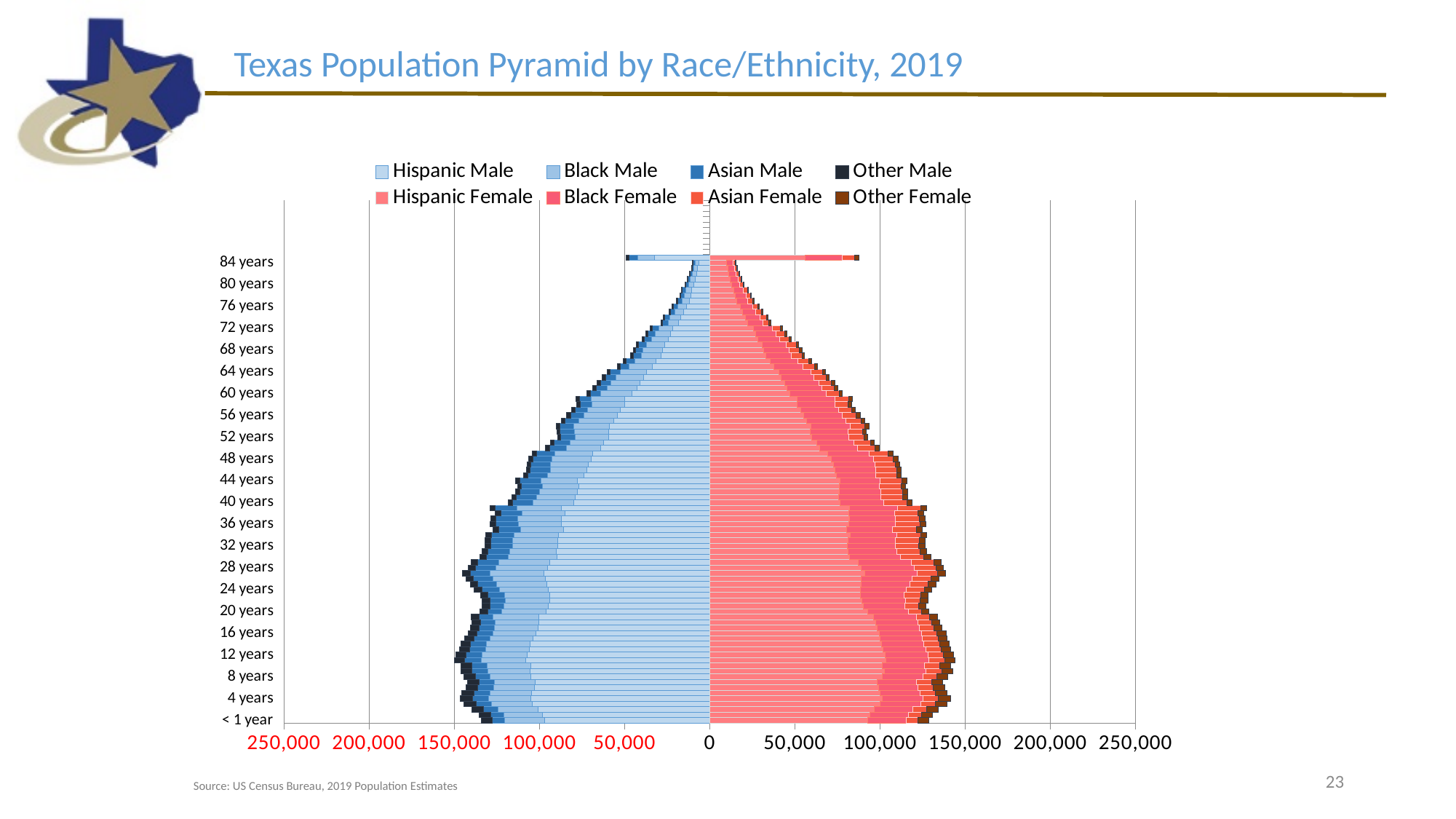
Is the total female bar for 84 years greater or less than 100,000? less Which legend entries are shown for the female side of the pyramid? Hispanic Female, Black Female, Asian Female, Other Female What is the title of the chart? Texas Population Pyramid by Race/Ethnicity, 2019 How many series does the legend list? 8 Moving up the axis from 40 years to 84 years, do the total bar lengths generally increase or decrease? Decrease Is the total male bar for 28 years greater or less than 150,000? less What kind of chart is shown on the slide? Bar chart (population pyramid) Is the total male bar for 72 years greater or less than 50,000? less Which is longer at 84 years, the total male bar or the total female bar? Female How many age labels are shown on the vertical axis? 22